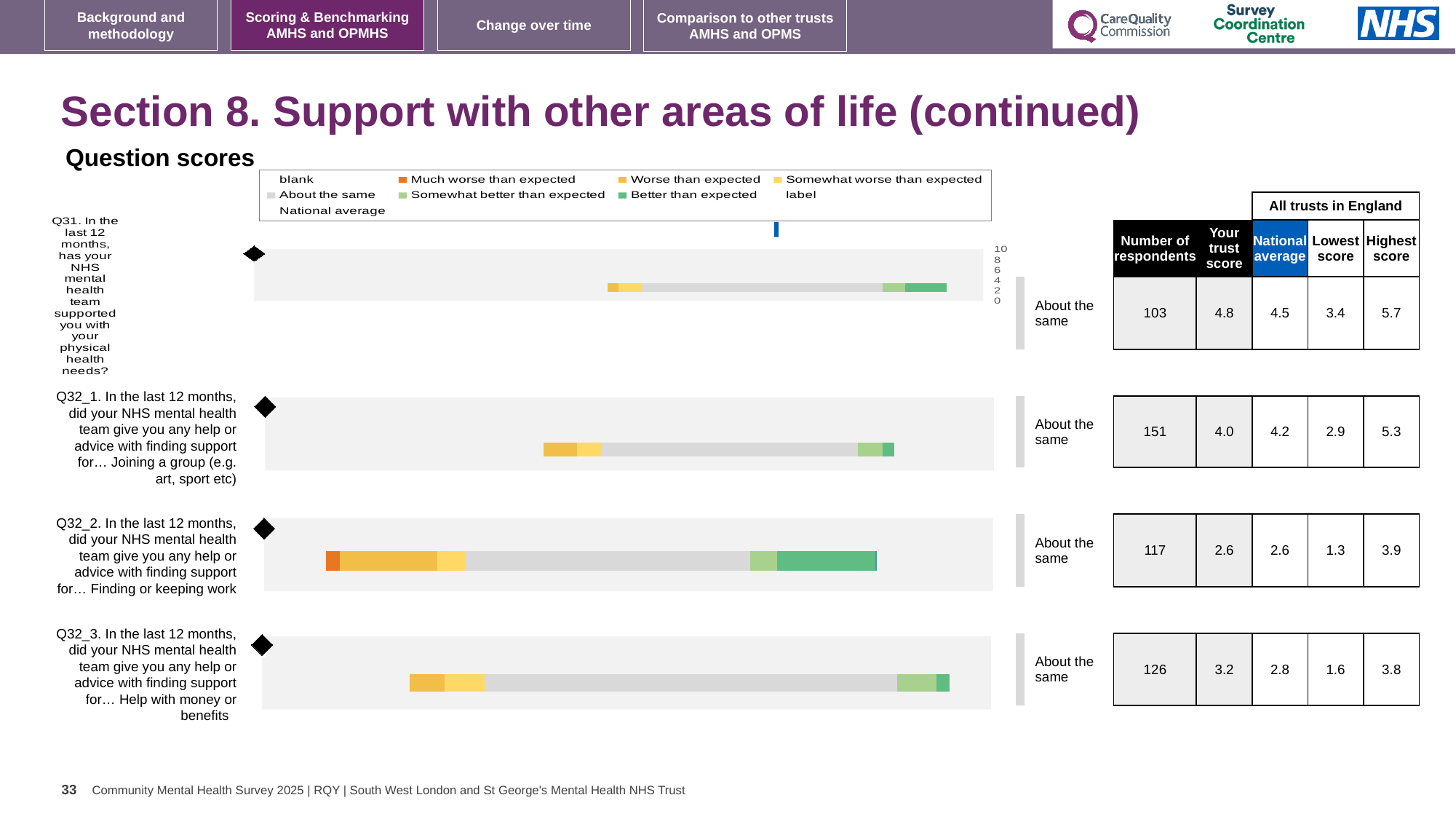
How many questions (bars) are shown in the question scores charts? 4 What is the difference between the trust score and the national average for Q32_3 (Help with money or benefits)? 0.4 Which question has the lowest trust score? Q32_2 (Finding or keeping work) How many respondents answered Q32_3 (Help with money or benefits)? 126 Which question has the highest number of respondents? Q32_1 (Joining a group) What is the national average for Q32_1 (Joining a group)? 4.2 How many entries does the legend above the charts list? 9 Is the trust score for Q32_1 (Joining a group) larger or smaller than its national average? smaller What is the trust score for Q31 (support with physical health needs)? 4.8 Which legend entry is shown in orange? Much worse than expected What kind of chart is used to show the question scores on this slide? bar chart What benchmark category is shown next to the bar for Q32_2 (Finding or keeping work)? About the same